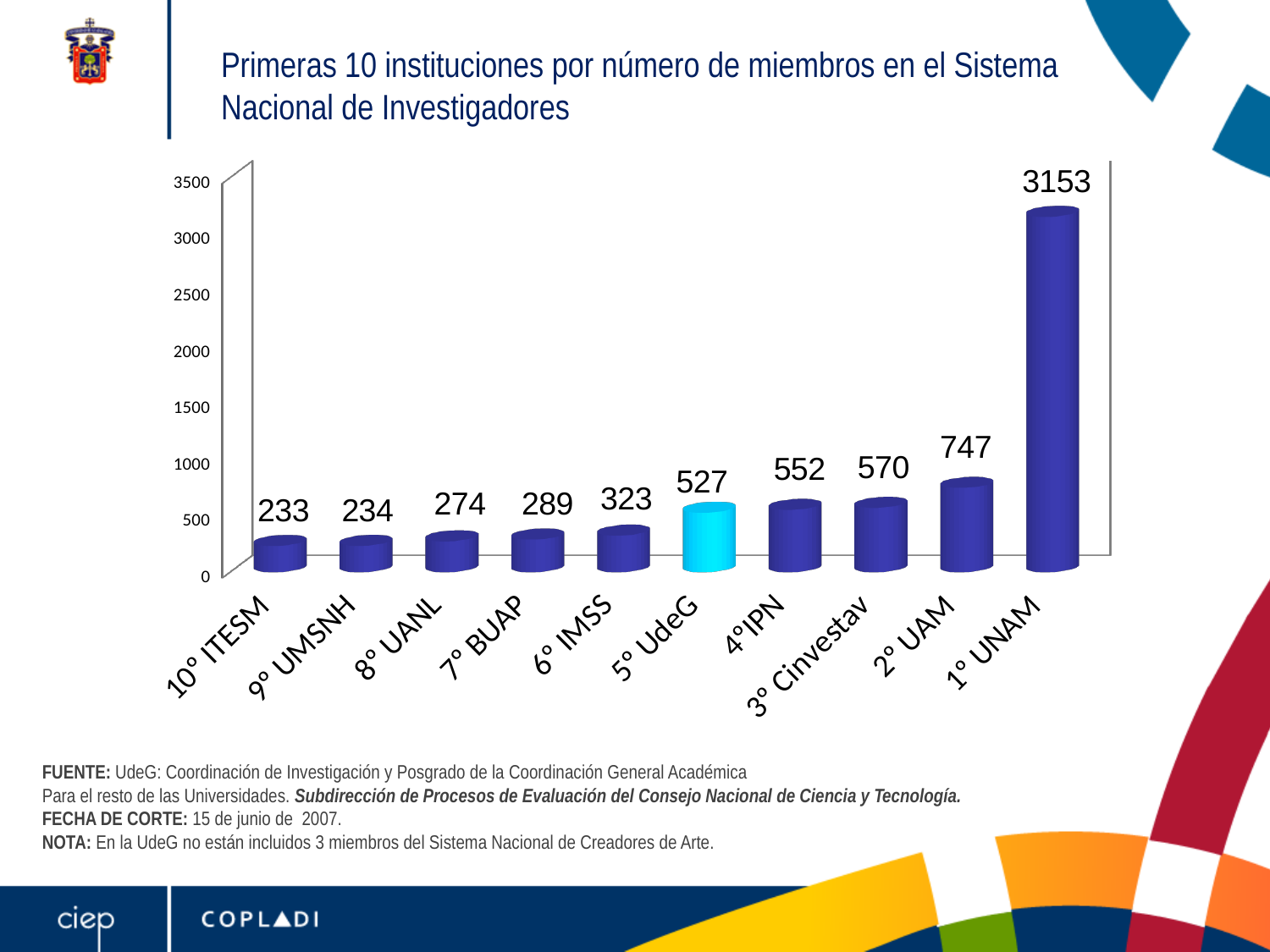
What is the difference between the values for 1° UNAM and 2° UAM? 2406 Which is larger, the value for 4°IPN or the value for 2° UAM? 2° UAM What is the value for 3° Cinvestav? 570 Which institution has the lowest number of members? 10° ITESM Is the value for 2° UAM greater or less than 1000? less What is the value for 5° UdeG? 527 Do the values rise or fall from left to right along the x axis? rise What kind of chart is shown on the slide? bar chart Which institution has the highest number of members? 1° UNAM What is the value for 1° UNAM? 3153 How many institutions are shown in the chart? 10 What is the difference between the values for 5° UdeG and 6° IMSS? 204